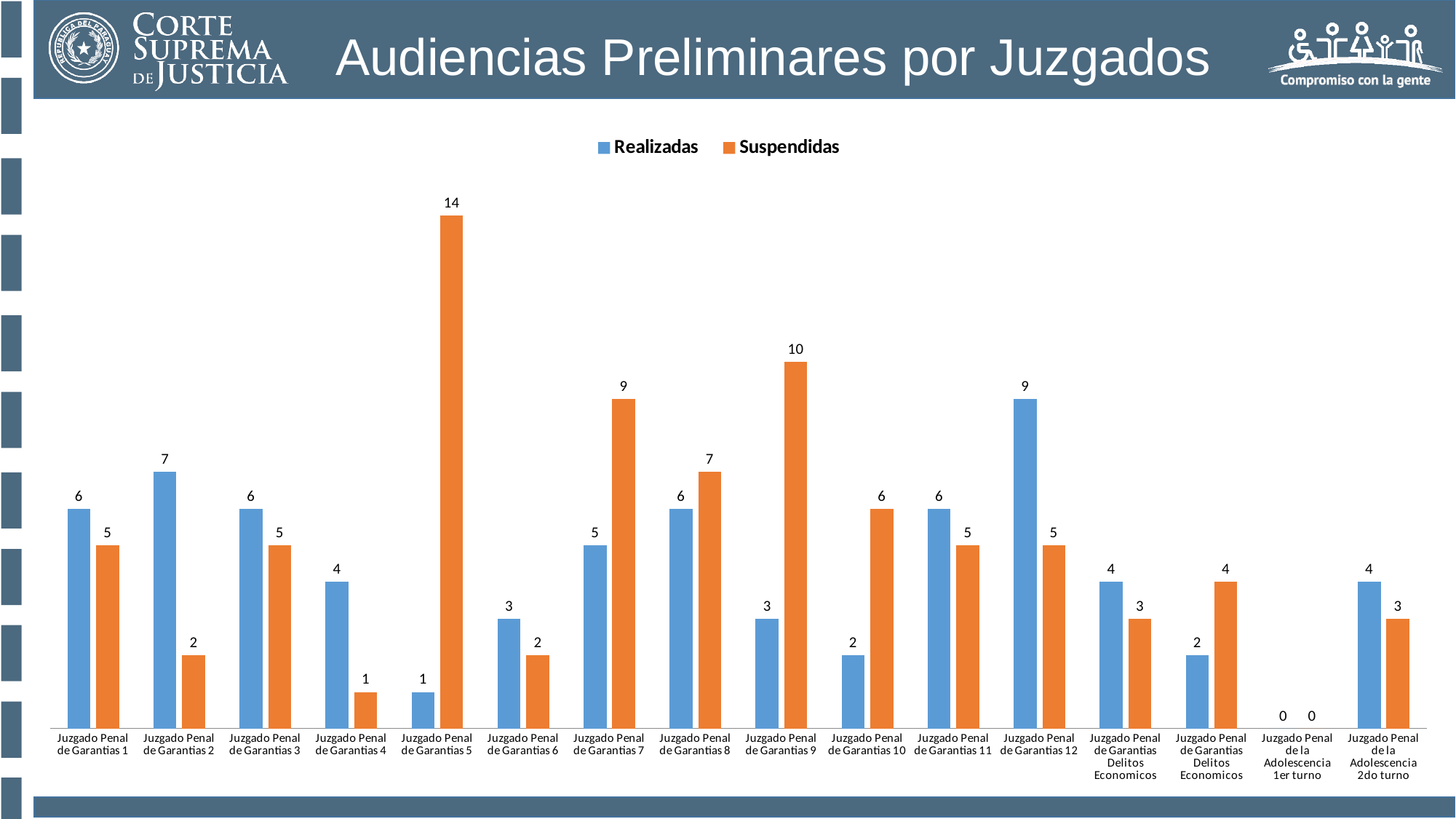
How many juzgados (categories) are shown on the x axis? 16 How many series does the legend list? 2 Which juzgado has the highest Realizadas value? Juzgado Penal de Garantias 12 What is the Realizadas value for Juzgado Penal de Garantias 12? 9 Which juzgado has the highest Suspendidas value? Juzgado Penal de Garantias 5 What is the difference between Suspendidas and Realizadas for Juzgado Penal de Garantias 7? 4 What kind of chart is shown on the slide? Bar chart For Juzgado Penal de Garantias 2, which is larger, Realizadas or Suspendidas? Realizadas Which juzgado has the lowest Realizadas value? Juzgado Penal de la Adolescencia 1er turno What is the Suspendidas value for Juzgado Penal de Garantias 5? 14 What is the Realizadas value for Juzgado Penal de Garantias 9? 3 What is the title of the slide? Audiencias Preliminares por Juzgados